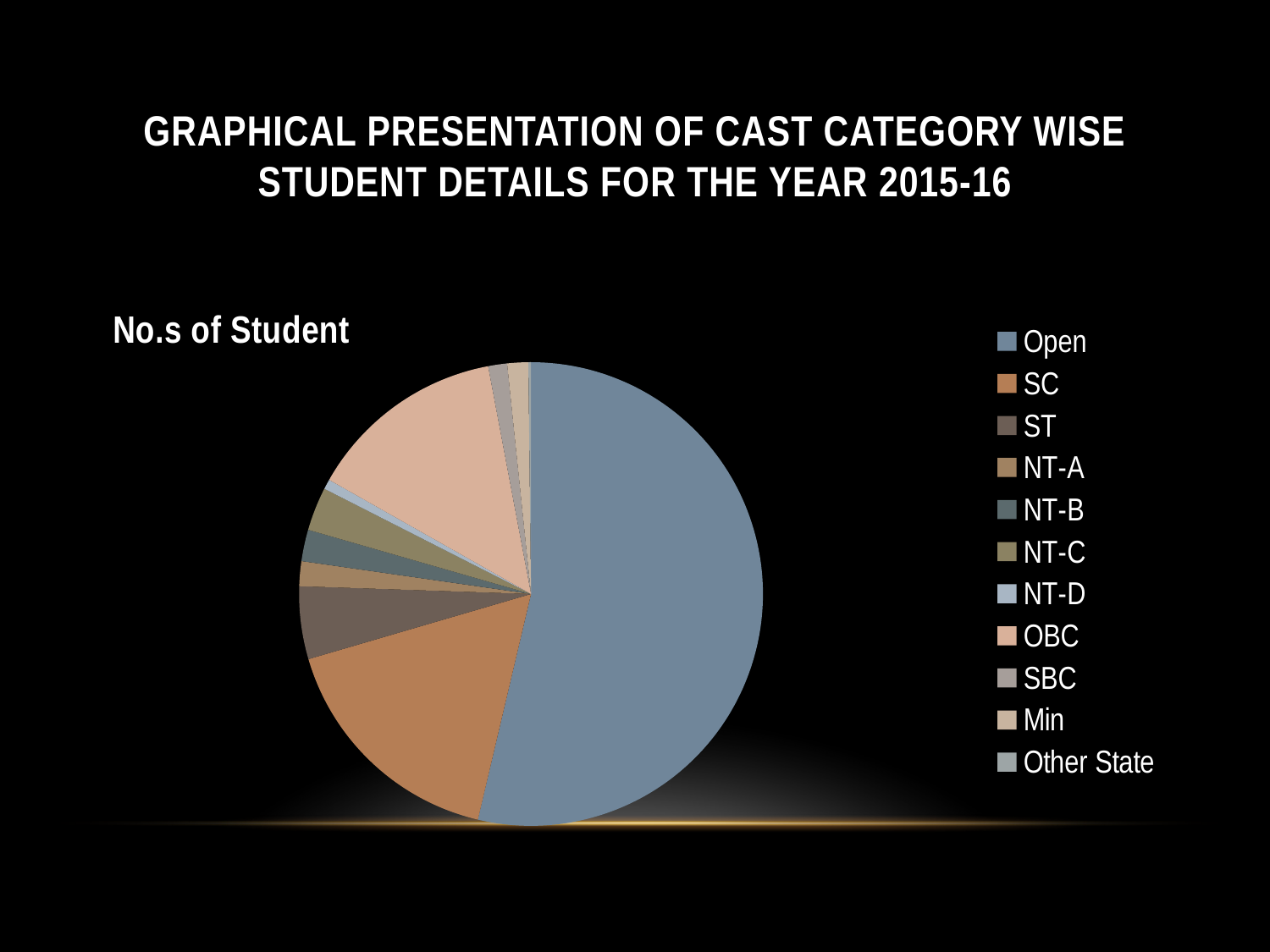
Which is larger, the slice for SC or the slice for ST? SC Which category has the largest slice of the pie? Open Which is larger, the slice for OBC or the slice for NT-A? OBC What is the title of the pie chart? No.s of Student What is the last entry listed in the chart legend? Other State Which is larger, the slice for ST or the slice for NT-D? ST How many categories does the pie chart show? 11 What kind of chart is shown on the slide? pie chart